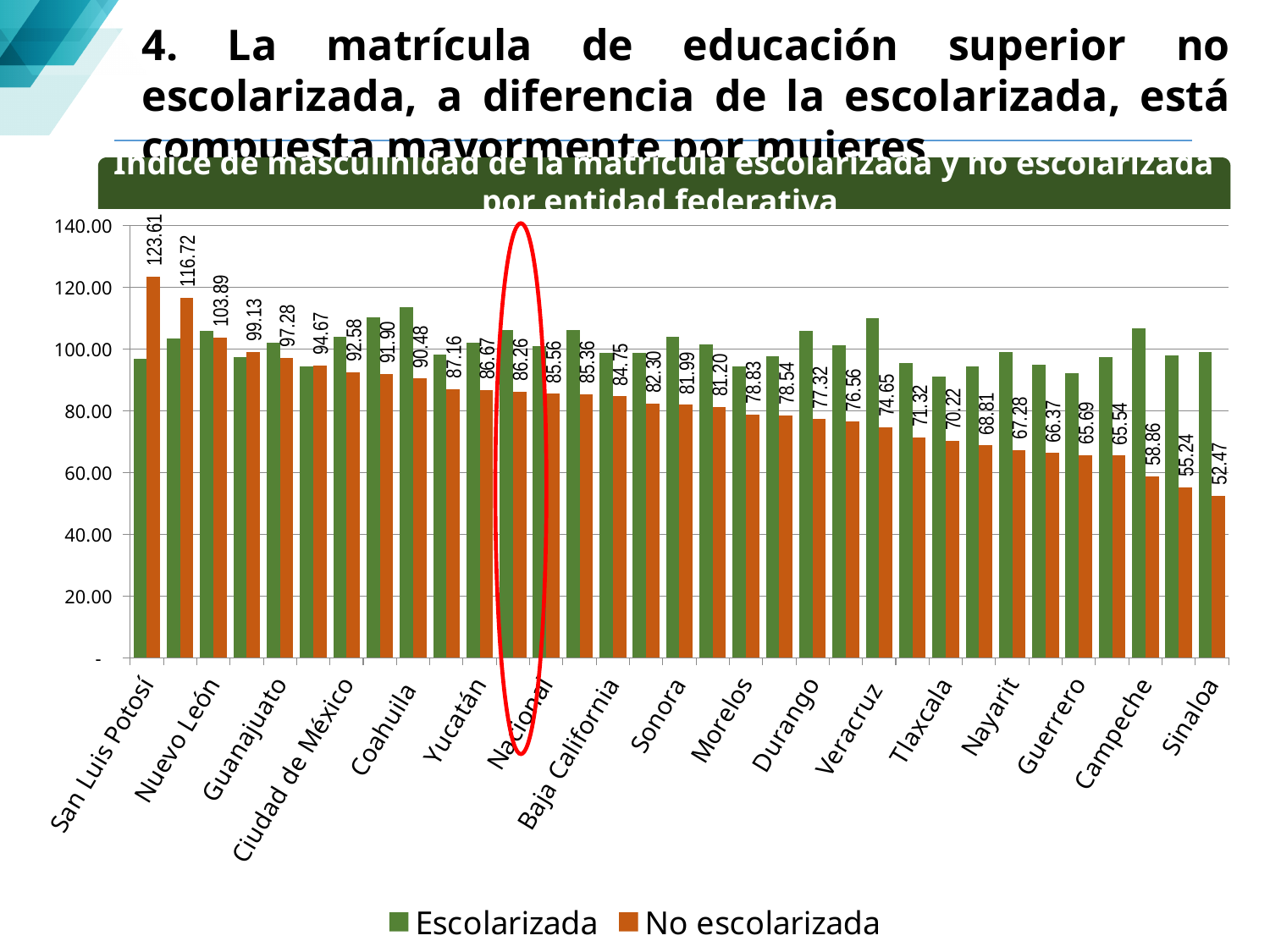
Which entity has the lowest No escolarizada value? Sinaloa What is the difference between the No escolarizada values for San Luis Potosí and Sinaloa? 71.14 What is the No escolarizada value for Sinaloa? 52.47 Is the Escolarizada value for Sinaloa greater or less than 80? greater What is the No escolarizada value for Nuevo León? 103.89 What is the No escolarizada value for Campeche? 58.86 What is the No escolarizada value for San Luis Potosí? 123.61 Which entity has the highest No escolarizada value? San Luis Potosí Do the No escolarizada values rise or fall from left to right along the x axis? Fall Which is larger, the No escolarizada value for Nuevo León or for Guerrero? Nuevo León What kind of chart is shown on the slide? Bar chart How many series does the legend list? 2